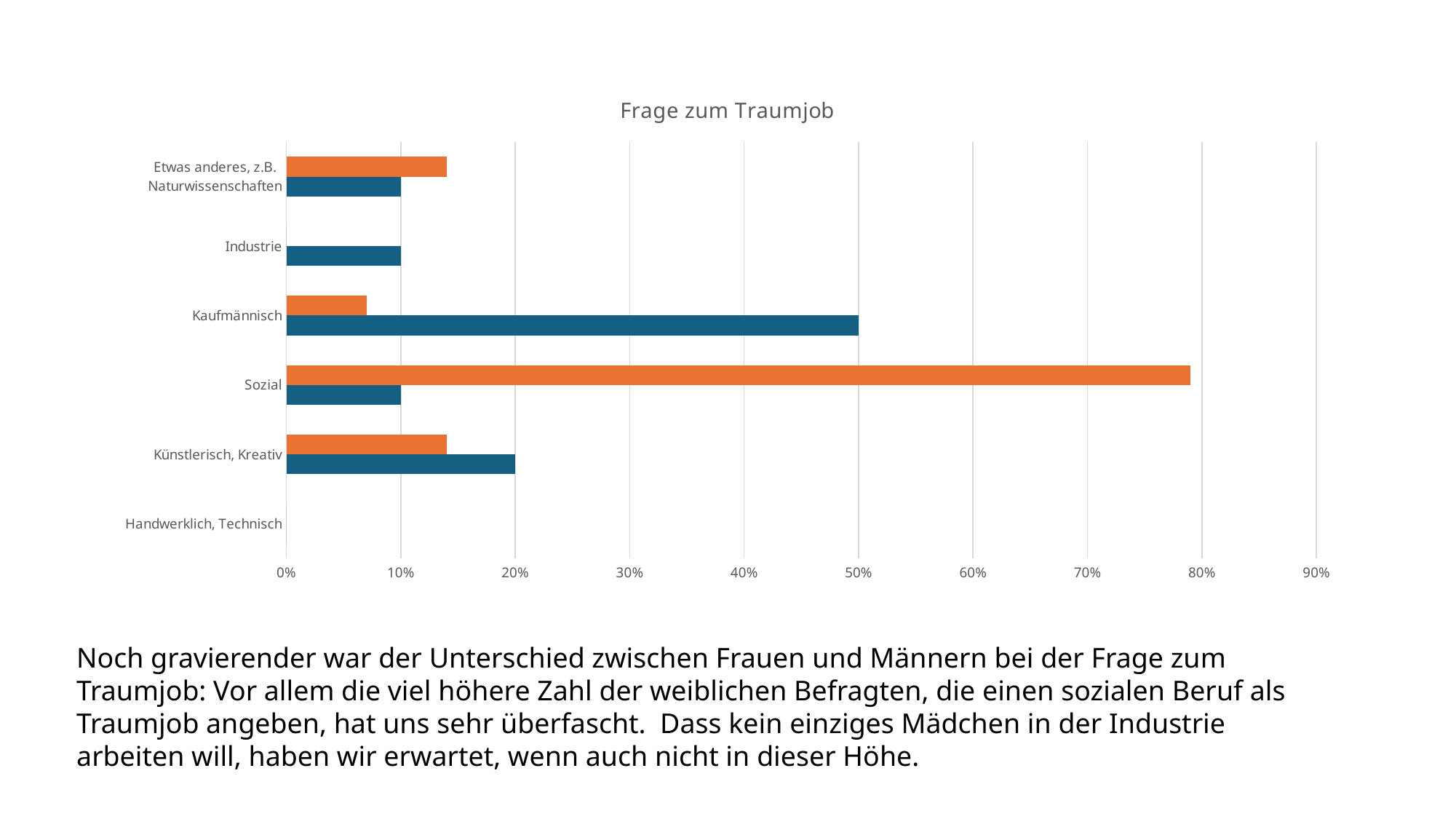
Is the value of the orange bar for Sozial greater or less than 70%? greater For Kaufmännisch, which bar is larger, the blue one or the orange one? the blue one Is the value of the orange bar for Kaufmännisch greater or less than 10%? less What is the value of the blue bar for Kaufmännisch? 50% What is the value of the blue bar for Künstlerisch, Kreativ? 20% Which category has the longest bar in the chart? Sozial What is the difference between the blue bar for Kaufmännisch and the blue bar for Künstlerisch, Kreativ? 30% What is the title of the chart? Frage zum Traumjob For Sozial, which bar is larger, the blue one or the orange one? the orange one What kind of chart is shown on the slide? bar chart How many categories are listed on the vertical axis of the chart? 6 What is the value of the blue bar for Industrie? 10%